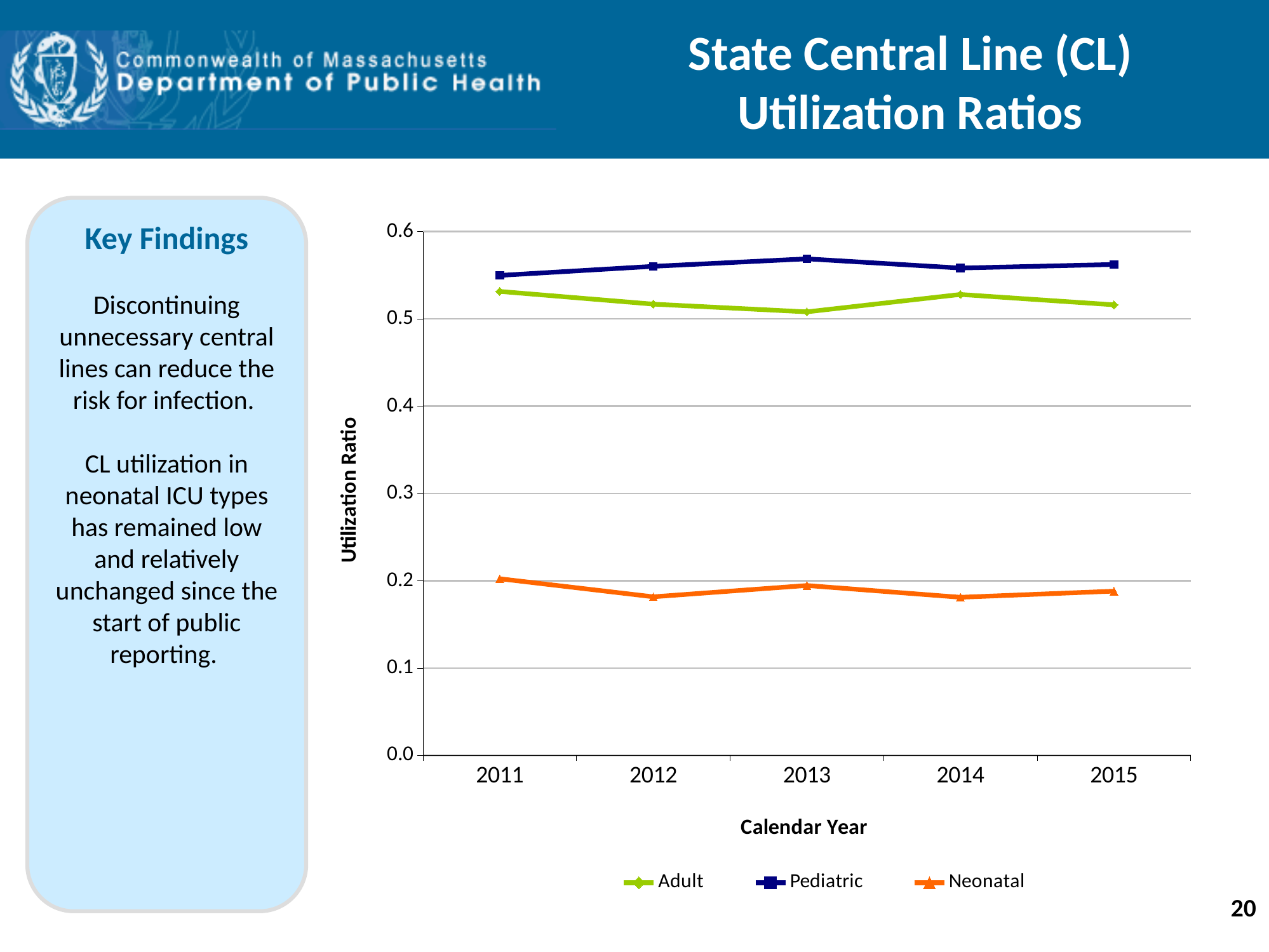
In 2013, which is larger: the Pediatric or the Adult utilization ratio? Pediatric Is the Pediatric utilization ratio in 2015 greater or less than 0.5? greater Which series has the highest utilization ratio across all years? Pediatric What kind of chart is shown on the slide? Line chart Does the Pediatric utilization ratio rise or fall from 2011 to 2013? rise How many calendar years are plotted on the x axis? 5 What is the label of the y axis? Utilization Ratio Which series has the lowest utilization ratio across all years? Neonatal Is the Adult utilization ratio in 2014 greater or less than 0.4? greater In 2011, which is larger: the Adult or the Neonatal utilization ratio? Adult How many series does the legend list? 3 Is the Neonatal utilization ratio in 2013 greater or less than 0.3? less